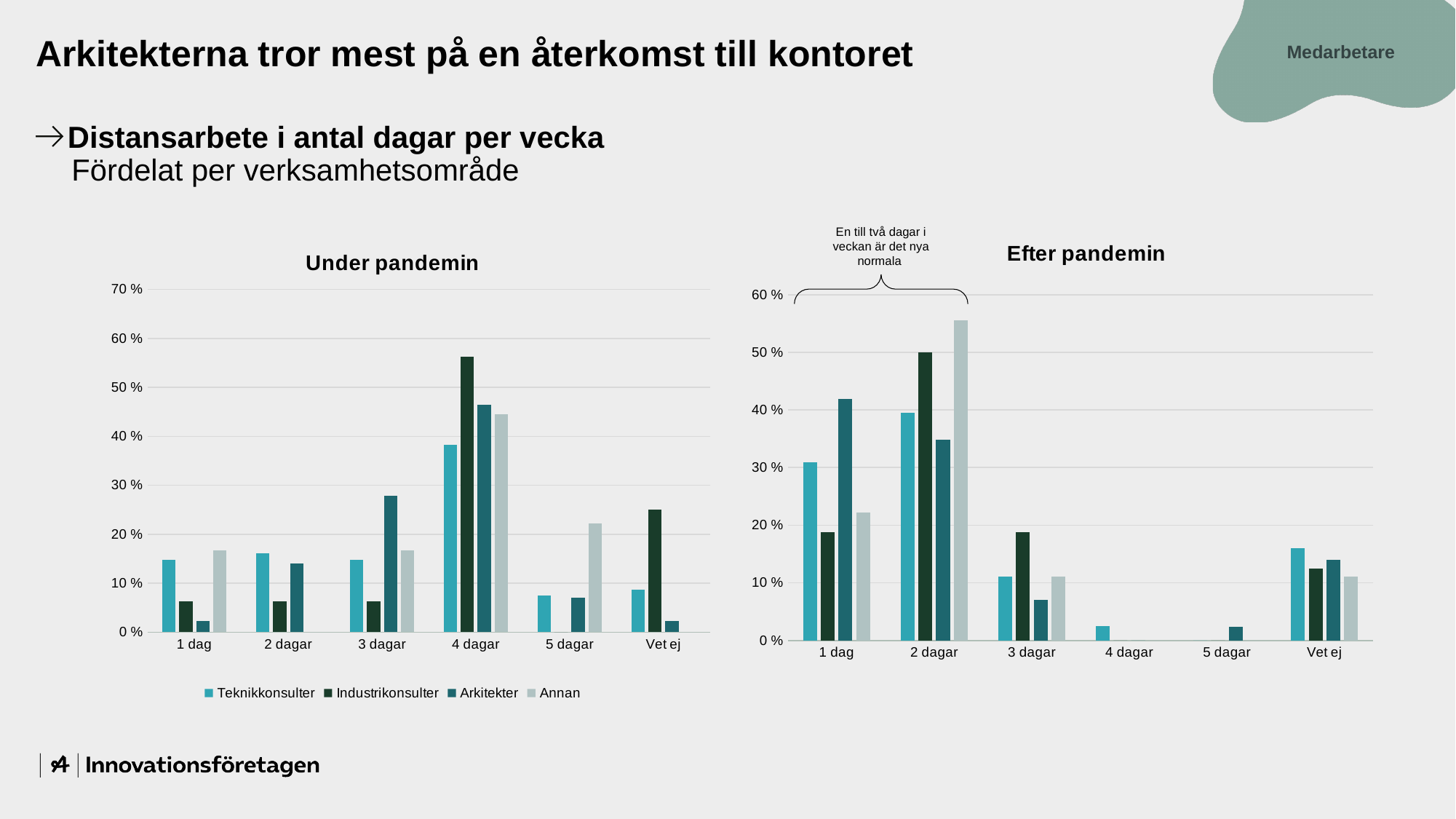
In the 'Under pandemin' chart, which series has the highest bar in the '4 dagar' category? Industrikonsulter In the 'Efter pandemin' chart, is the value for Teknikkonsulter at 'Vet ej' greater or less than 10 %? greater How many categories are shown on the x axis of the 'Efter pandemin' chart? 6 In the 'Under pandemin' chart, is the value for Arkitekter at '3 dagar' greater or less than 20 %? greater In the 'Efter pandemin' chart, which series has the highest bar in the '2 dagar' category? Annan In the 'Efter pandemin' chart, which is larger at '2 dagar': Industrikonsulter or Arkitekter? Industrikonsulter In the 'Efter pandemin' chart, which series has the highest bar in the '1 dag' category? Arkitekter In the 'Under pandemin' chart, which is larger at '5 dagar': Annan or Teknikkonsulter? Annan How many series does the legend list for the 'Under pandemin' chart? 4 In the 'Efter pandemin' chart, is the value for Arkitekter at '1 dag' greater or less than 40 %? greater What kind of chart is the 'Under pandemin' chart? bar chart